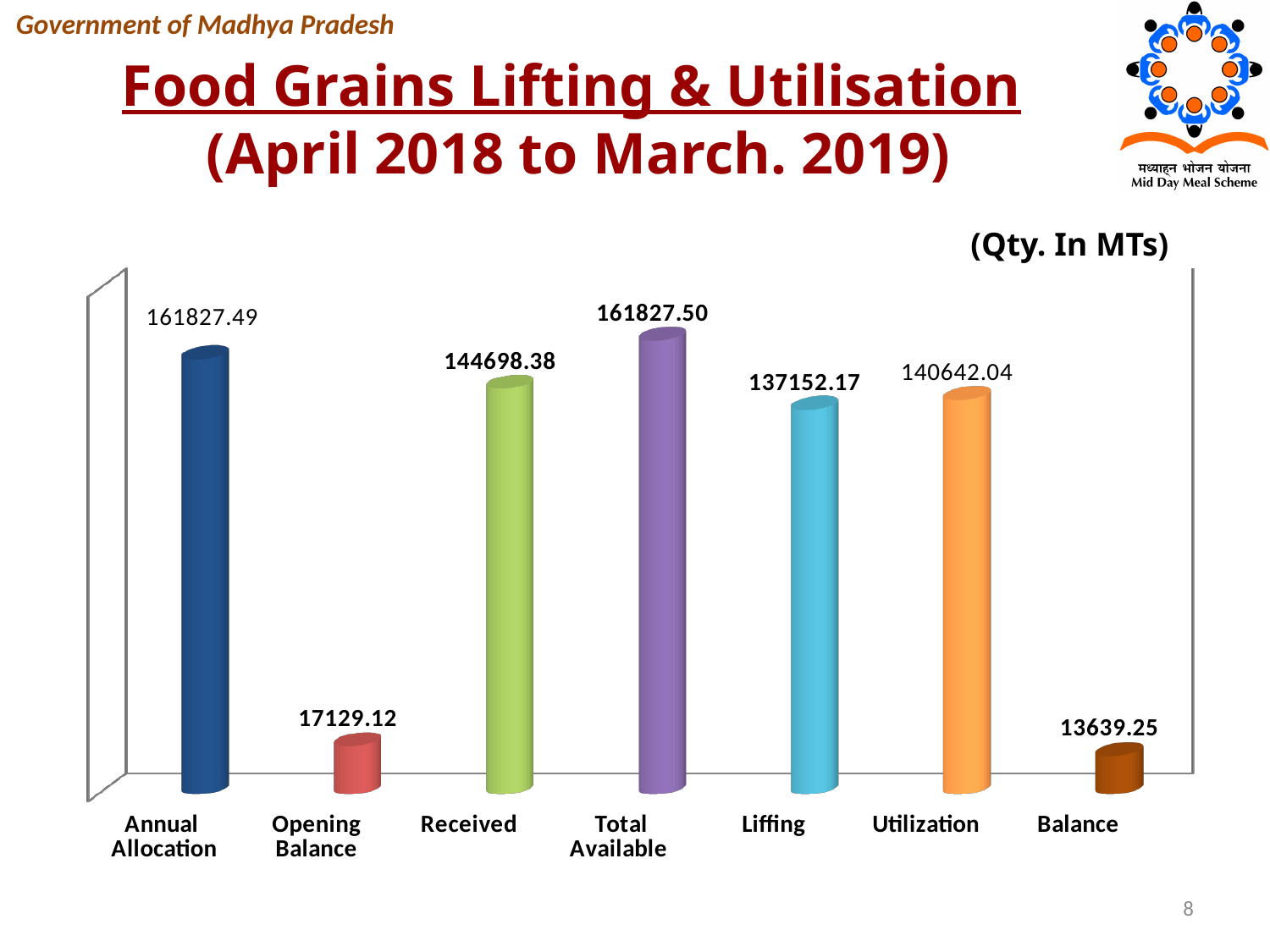
How many categories are shown in the chart? 7 What is the difference between Utilization and Lifting? 3489.87 What is the value for Utilization? 140642.04 What is the value for Lifting? 137152.17 What kind of chart is shown on the slide? Bar chart What is the value for Received? 144698.38 What is the value for Annual Allocation? 161827.49 What is the difference between Opening Balance and Balance? 3489.87 What is the value for Opening Balance? 17129.12 Which is larger, Received or Lifting? Received Which category has the lowest value? Balance In what unit are the quantities in the chart expressed? MTs